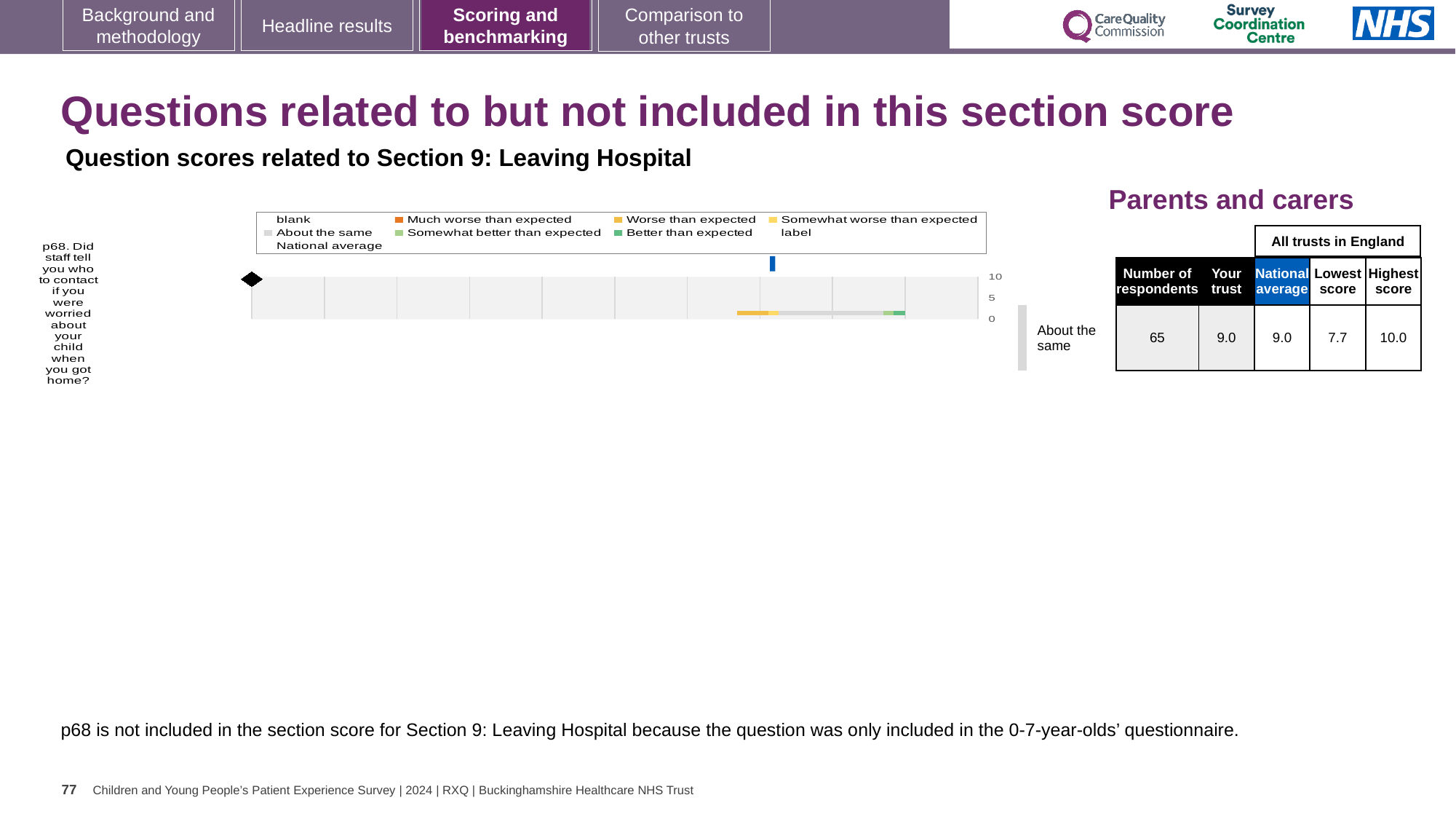
According to the table beside the chart, what is the national average score for p68? 9.0 According to the table beside the chart, how many respondents answered p68? 65 What kind of chart is shown on the slide? bar chart How many entries does the chart legend list? 9 Which question is plotted on the chart? p68. Did staff tell you who to contact if you were worried about your child when you got home? What is the highest value shown on the chart's axis? 10 What is the difference between the highest score and the lowest score for p68 in the table beside the chart? 2.3 According to the table beside the chart, what is the 'Your trust' score for p68? 9.0 According to the table beside the chart, what is the lowest score among all trusts in England for p68? 7.7 According to the table beside the chart, what is the highest score among all trusts in England for p68? 10.0 How many question categories are plotted on the chart? 1 What benchmark category is the trust's p68 score assigned to on the slide? About the same